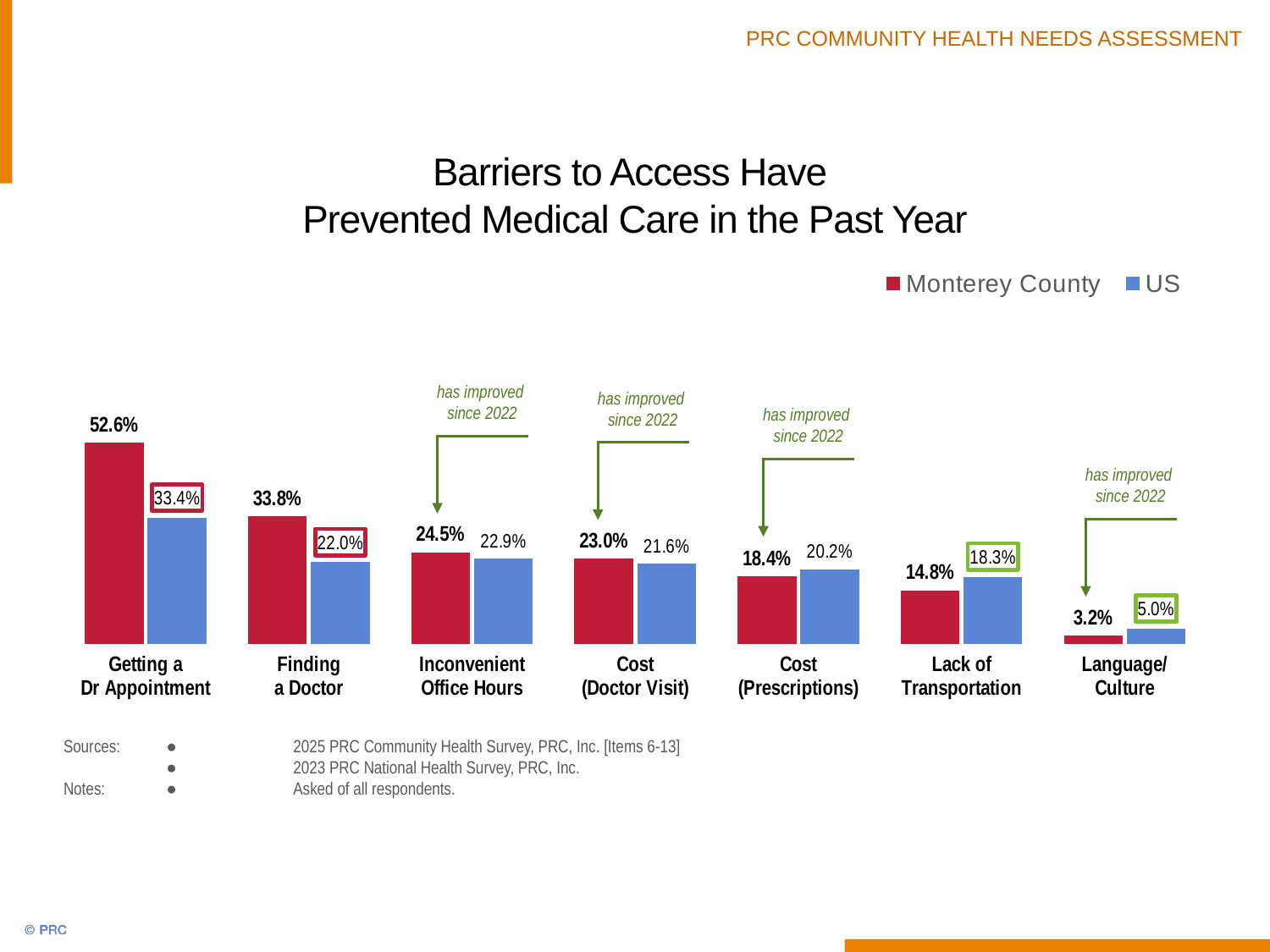
What is the US value for Language/Culture? 5.0% Which barrier has the lowest US value? Language/Culture What is the US value for Finding a Doctor? 22.0% What kind of chart is shown on the slide? Bar chart What is the Monterey County value for Getting a Dr Appointment? 52.6% How many series does the legend list? 2 Which is larger for Cost (Prescriptions): the Monterey County value or the US value? US Which colour represents Monterey County in the chart? Red What is the difference between the Monterey County and US values for Getting a Dr Appointment? 19.2% What is the Monterey County value for Lack of Transportation? 14.8% Which barrier has the highest Monterey County value? Getting a Dr Appointment How many barrier categories are shown on the chart? 7